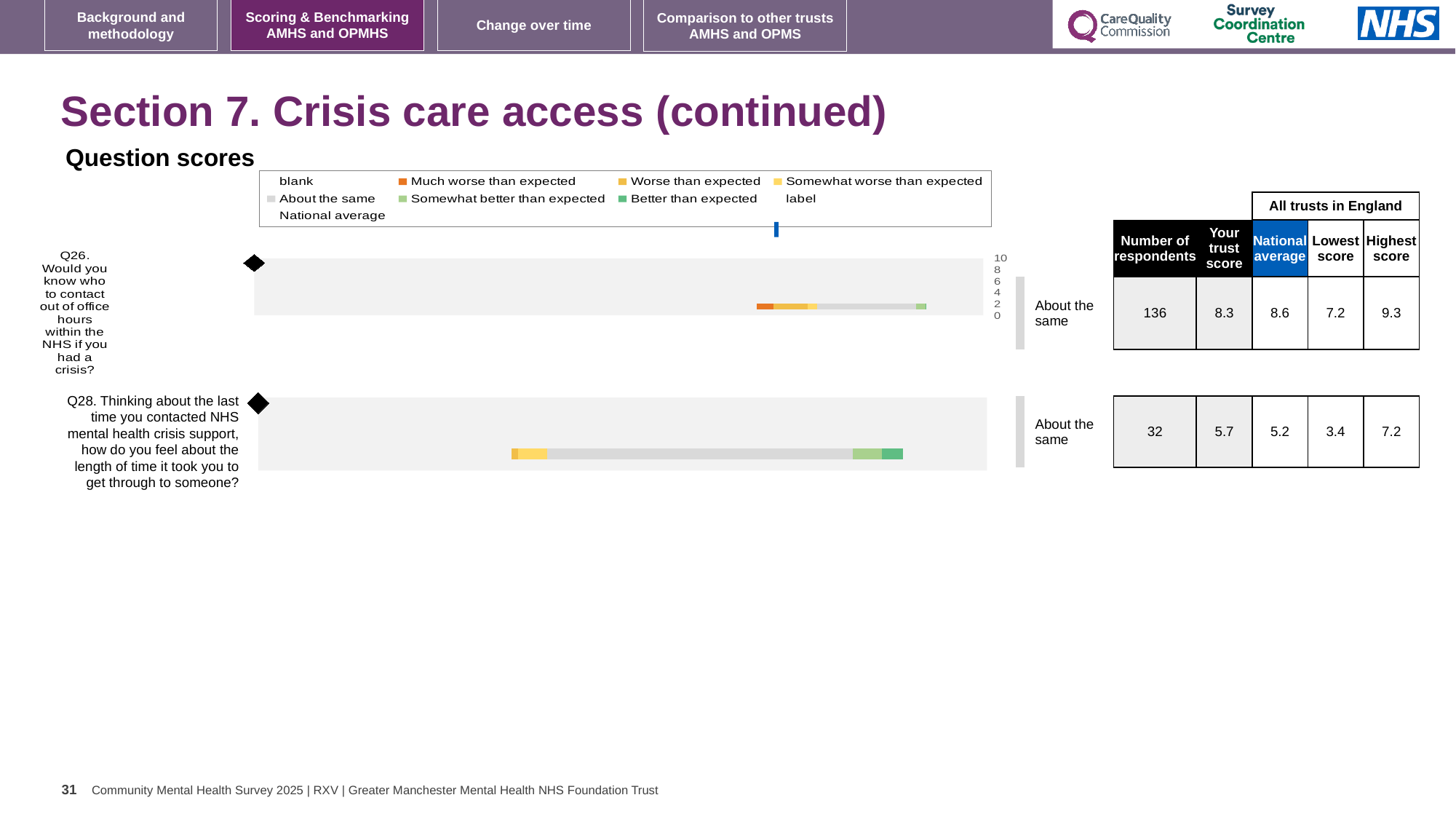
What is the trust score for Q28 (length of time to get through to crisis support)? 5.7 What is the trust score for Q26 (knowing who to contact out of office hours)? 8.3 What colour represents 'Much worse than expected' in the legend? orange What is the difference between the trust scores for Q26 and Q28? 2.6 What is the national average score for Q28? 5.2 How many questions (bars) are shown in the question scores chart? 2 How many respondents answered Q26? 136 Which question has the higher trust score, Q26 or Q28? Q26 Which benchmark category does Q26 fall into? About the same What is the highest value shown on the axis of the Q26 chart? 10 Which benchmark category does Q28 fall into? About the same What kind of chart is used to show the question scores for Q26 and Q28? bar chart